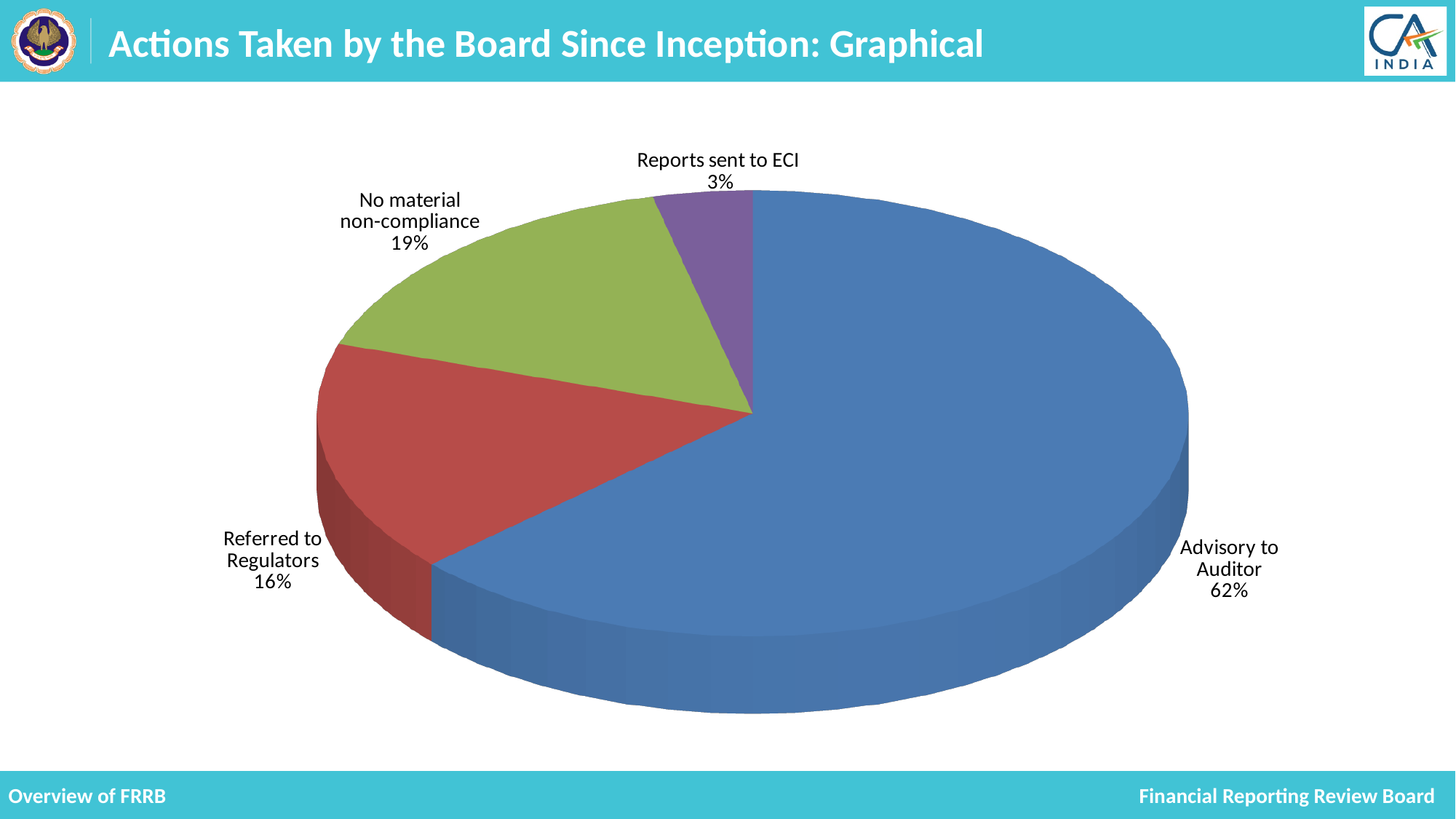
What share of the pie is labelled Reports sent to ECI? 3% What share of the pie is labelled Referred to Regulators? 16% Which category has the smallest slice of the pie? Reports sent to ECI What is the difference in percentage points between Referred to Regulators and Reports sent to ECI? 13 What is the difference in percentage points between Advisory to Auditor and No material non-compliance? 43 Which is larger, the share for No material non-compliance or the share for Referred to Regulators? No material non-compliance What share of the pie is labelled No material non-compliance? 19% Which category has the largest slice of the pie? Advisory to Auditor How many slices does the pie chart have? 4 What kind of chart is shown on the slide? Pie chart What colour is the Advisory to Auditor slice? Blue